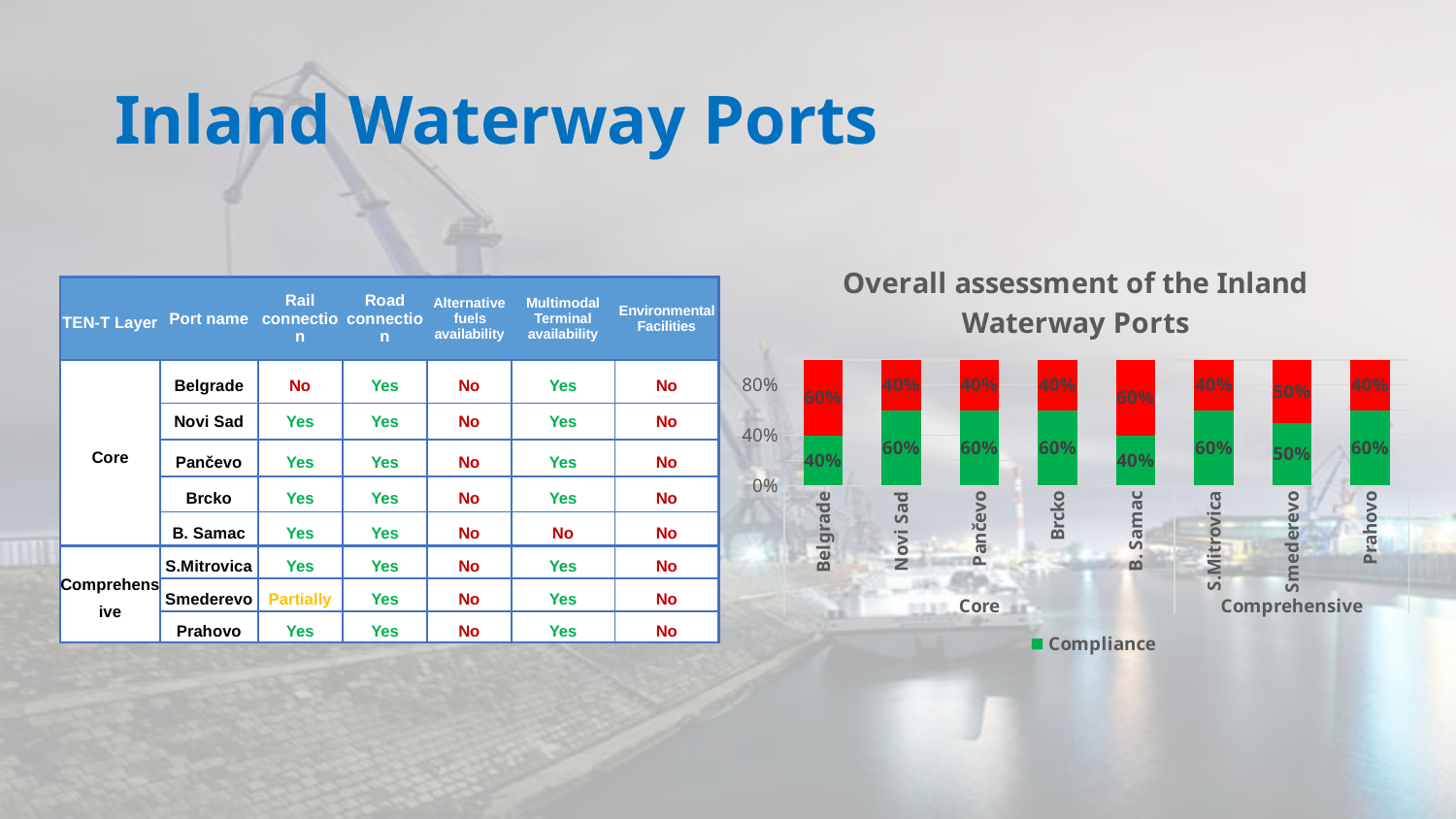
Which group label on the x axis covers S.Mitrovica, Smederevo and Prahovo? Comprehensive Which port has the lowest Compliance (green) value in the chart, Belgrade or Novi Sad? Belgrade What is the Compliance (green) value for Smederevo in the chart? 50% What is the Compliance (green) value for Belgrade in the chart? 40% What is the Compliance (green) value for Novi Sad in the chart? 60% What is the red (non-compliance) value for B. Samac in the chart? 60% What is the title of the chart on the slide? Overall assessment of the Inland Waterway Ports How many ports are shown on the x axis of the chart? 8 How many entries does the chart's legend list? 1 What kind of chart is shown on the slide? stacked bar chart What is the total of the stacked bar for Prahovo? 100% What is the difference between the Compliance (green) values for Brcko and Belgrade? 20%